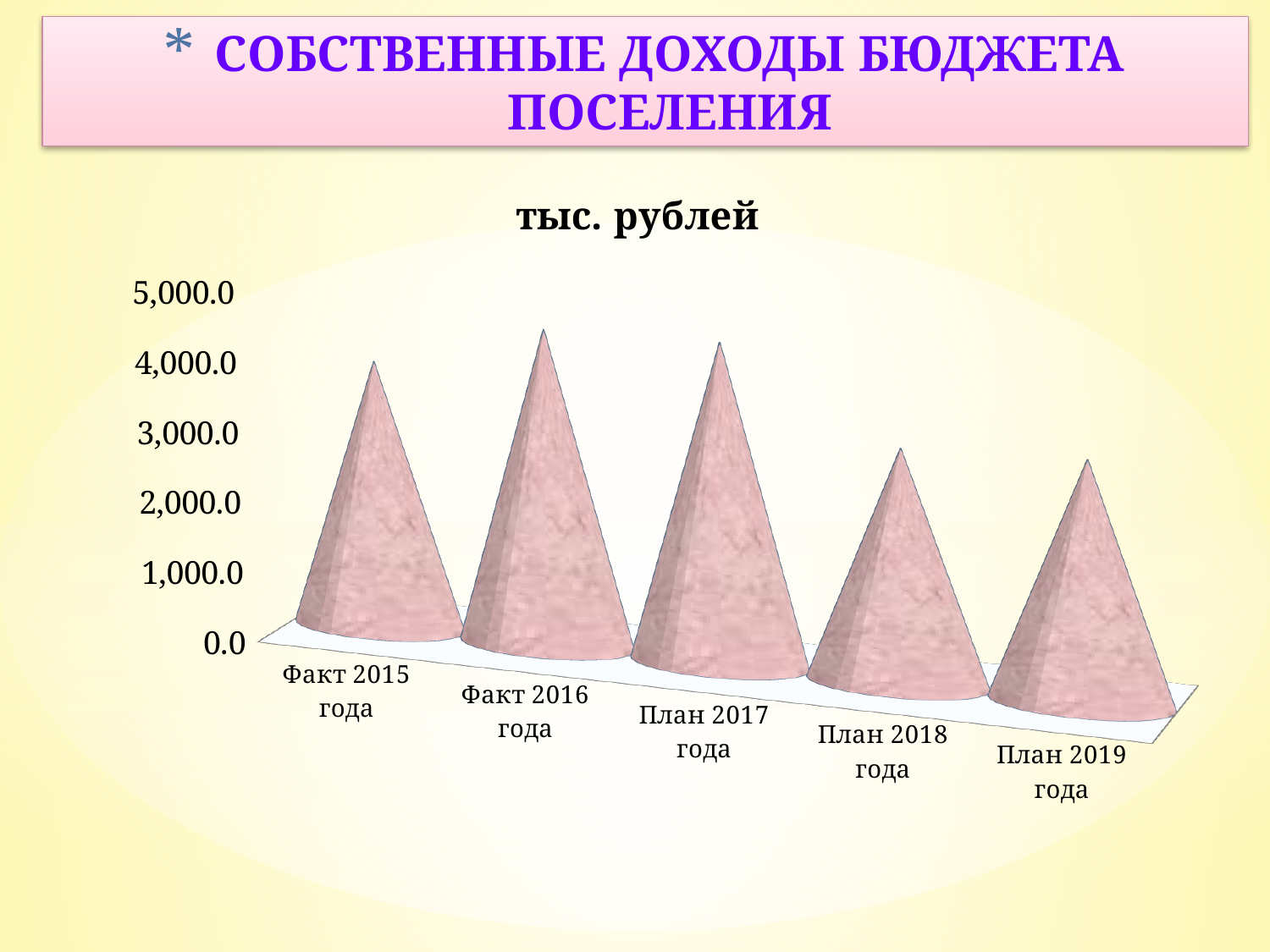
Is the value for План 2019 года greater or less than 2,000.0? greater How many categories are shown on the x axis of the chart? 5 Is the value for Факт 2016 года greater or less than 4,000.0? greater Do the values rise or fall from План 2017 года to План 2019 года? fall What kind of chart is shown on the slide? bar chart Which is larger, the value for Факт 2015 года or the value for План 2018 года? Факт 2015 года Do the values rise or fall from Факт 2015 года to Факт 2016 года? rise Is the value for План 2019 года greater or less than 4,000.0? less What is the title of the chart? тыс. рублей Which is larger, the value for Факт 2016 года or the value for План 2019 года? Факт 2016 года